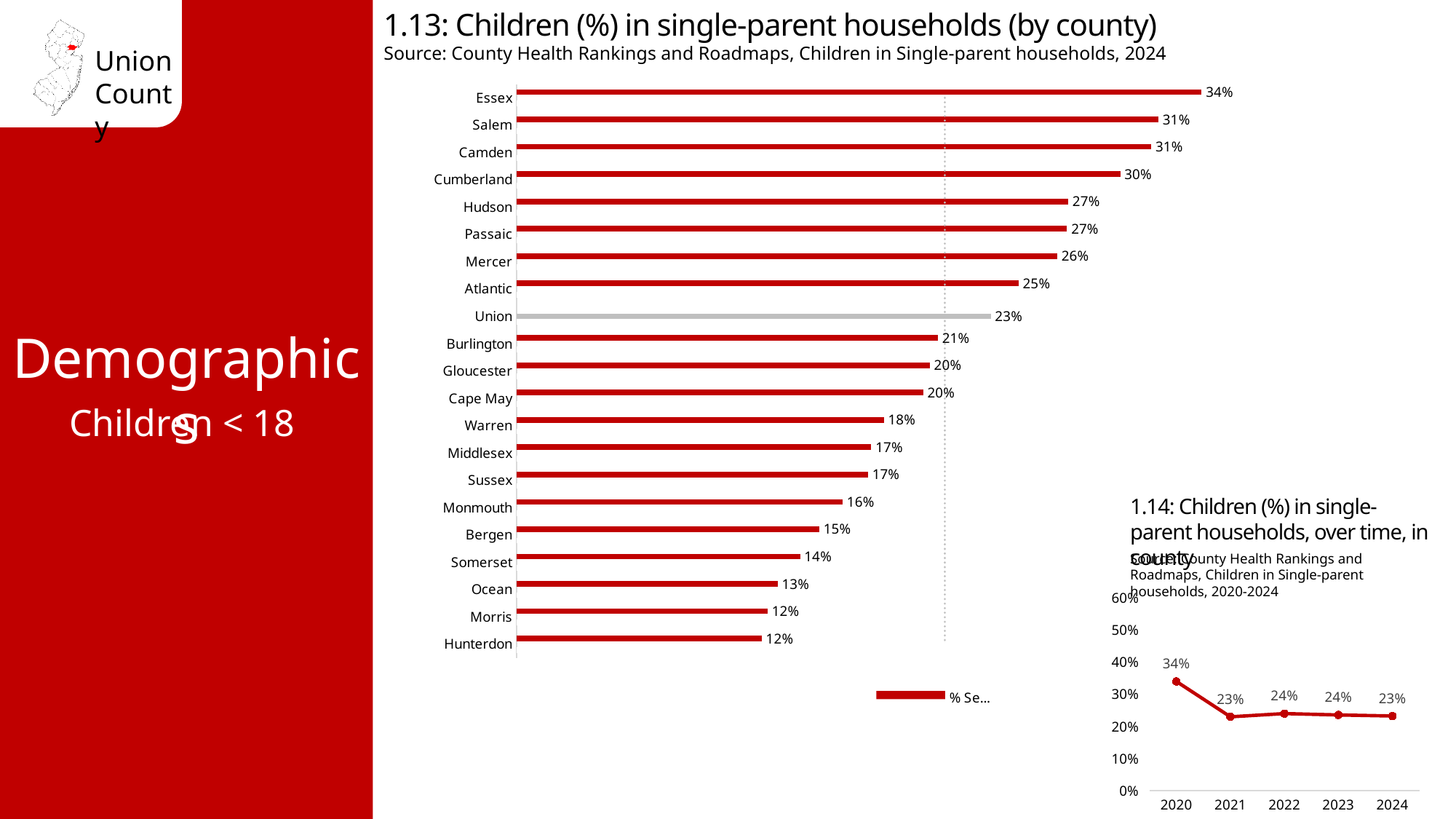
In chart 1.13 (Children in single-parent households by county), what is the value for Union? 23% In chart 1.14 (over time, in county), what is the value for 2020? 34% In chart 1.13 (by county), what is the value for Hudson? 27% In chart 1.14 (over time, in county), how many years are plotted? 5 In chart 1.13 (by county), what is the difference between Essex and Union? 11 percentage points In chart 1.13 (by county), which is larger, the value for Bergen or the value for Somerset? Bergen What kind of chart is chart 1.13 (Children in single-parent households by county)? Bar chart In chart 1.13 (by county), which bar is shown in grey rather than red? Union In chart 1.13 (by county), which county has the highest percentage of children in single-parent households? Essex What kind of chart is chart 1.14 (Children in single-parent households over time)? Line chart In chart 1.13 (by county), how many counties are shown? 21 In chart 1.14 (over time, in county), what is the difference between 2020 and 2021? 11 percentage points